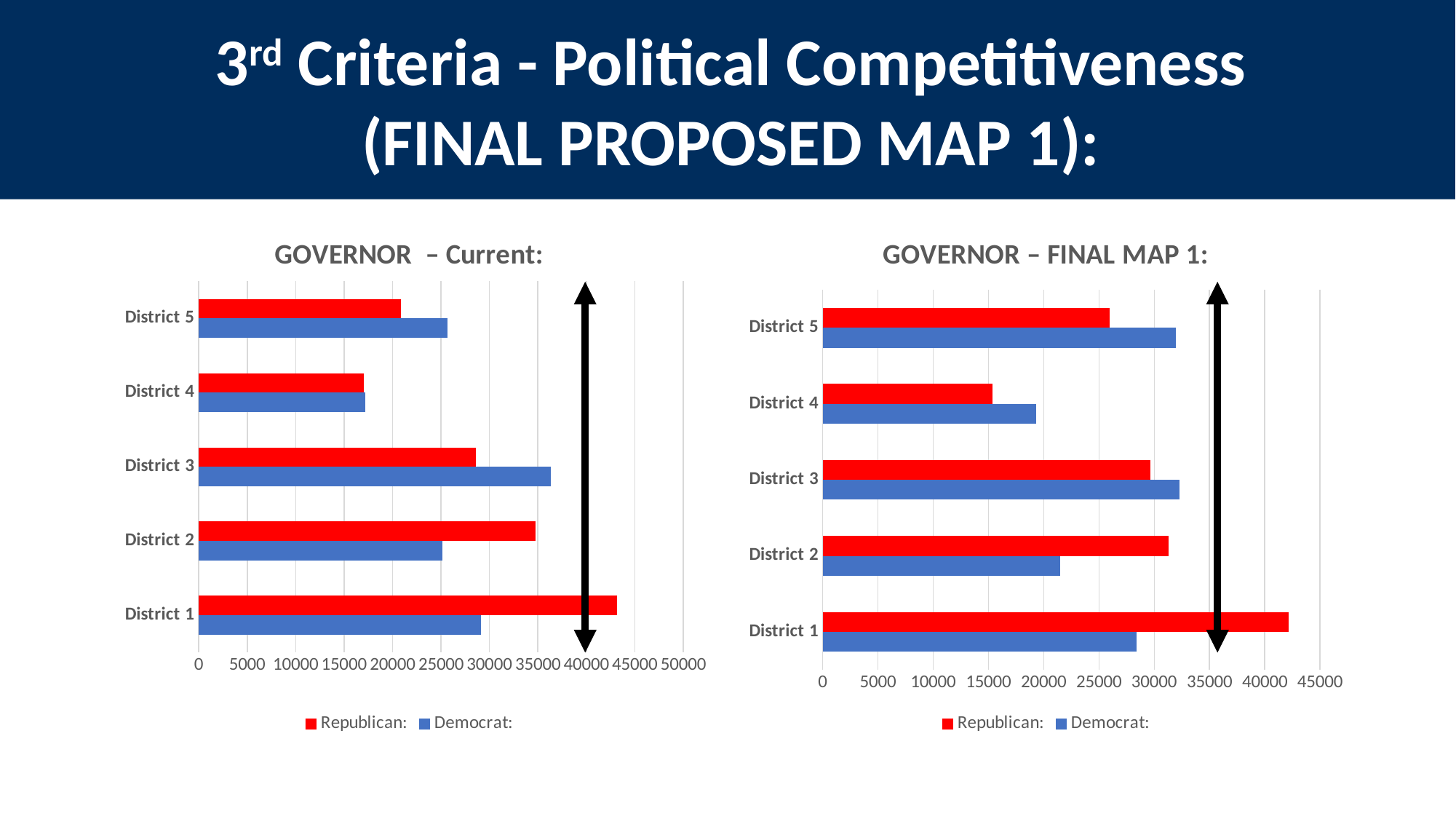
On the GOVERNOR – Current chart, is the Republican value for District 1 greater or less than 40000? greater On the GOVERNOR – Current chart, which district has the highest Republican value? District 1 On the GOVERNOR – FINAL MAP 1 chart, for District 2, which is larger: Republican or Democrat? Republican What kind of chart is the GOVERNOR – Current chart? bar chart What are the two legend entries on the GOVERNOR – FINAL MAP 1 chart? Republican and Democrat On the GOVERNOR – FINAL MAP 1 chart, which district has the lowest Republican value? District 4 How many districts are shown on the GOVERNOR – Current chart? 5 On the GOVERNOR – FINAL MAP 1 chart, is the Democrat value for District 5 greater or less than 30000? greater On the GOVERNOR – Current chart, which district has the lowest Democrat value? District 4 On the GOVERNOR – Current chart, for District 3, which is larger: Republican or Democrat? Democrat How many series does the legend of the GOVERNOR – FINAL MAP 1 chart list? 2 On the GOVERNOR – Current chart, is the Democrat value for District 2 greater or less than 30000? less